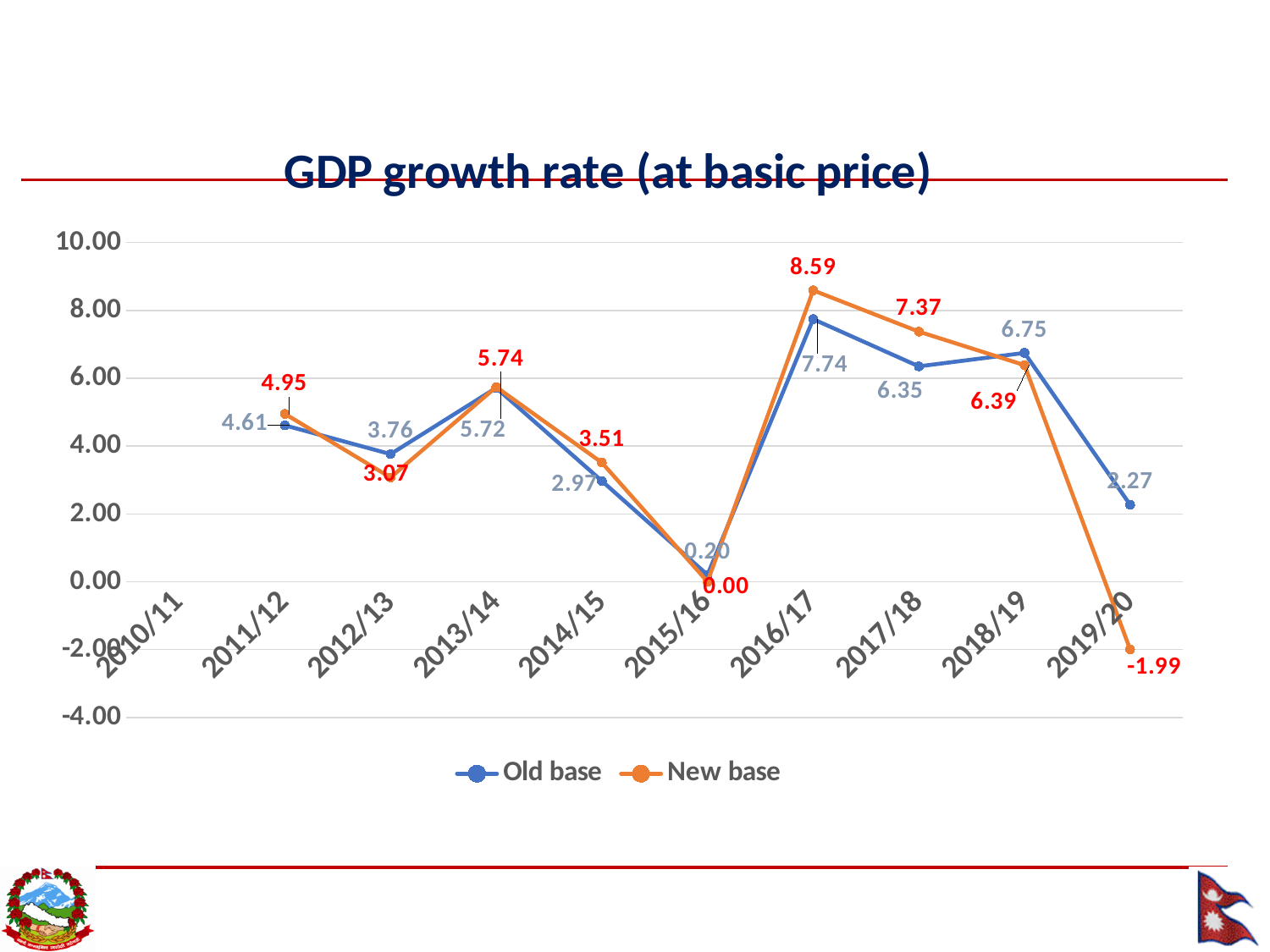
How many series does the legend list? 2 Which is larger for 2018/19, the Old base value or the New base value? Old base Between 2018/19 and 2019/20, does the New base line rise or fall? Fall Which year has the highest New base growth rate? 2016/17 What is the title of the chart? GDP growth rate (at basic price) What is the Old base GDP growth rate for 2016/17? 7.74 What is the New base value for 2013/14? 5.74 What type of chart is shown on the slide? Line chart Which year has the lowest Old base growth rate? 2015/16 What is the difference between the New base and Old base values for 2016/17? 0.85 What is the New base GDP growth rate for 2019/20? -1.99 Is the New base value for 2017/18 greater or less than 6.00? greater